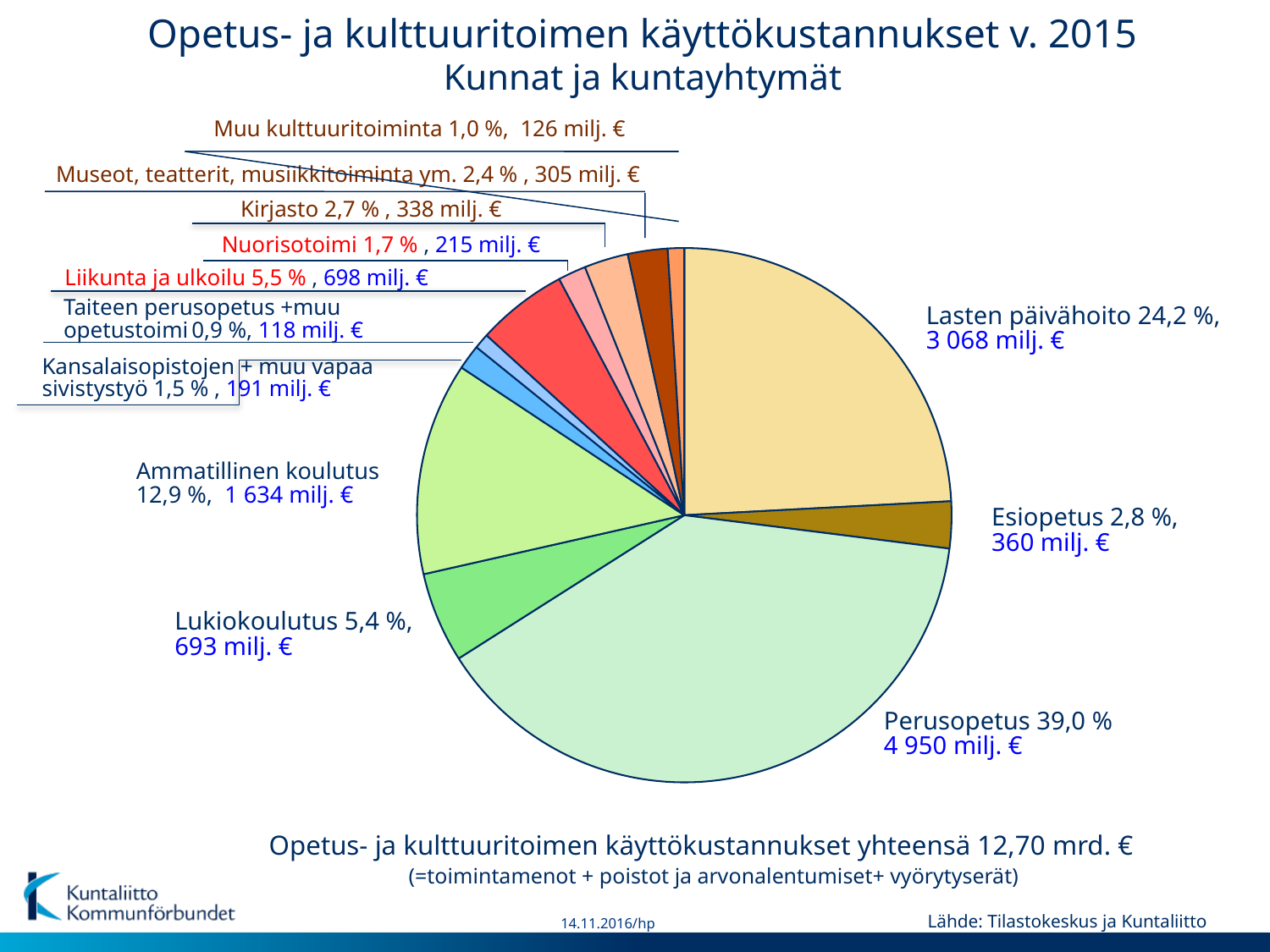
What is the value in milj. € for Perusopetus? 4 950 milj. € What is the total of Opetus- ja kulttuuritoimen käyttökustannukset stated on the slide? 12,70 mrd. € How many slices does the pie chart have? 12 What share of the pie does Esiopetus represent? 2,8 % Which category has the largest slice of the pie? Perusopetus What share of the pie does Liikunta ja ulkoilu represent? 5,5 % What is the value in milj. € for Lasten päivähoito? 3 068 milj. € What kind of chart is shown on the slide? pie chart Which category has the smallest slice of the pie? Taiteen perusopetus + muu opetustoimi What is the difference in milj. € between Perusopetus and Lasten päivähoito? 1 882 milj. € What is the value in milj. € for Ammatillinen koulutus? 1 634 milj. € Which is larger, Kirjasto or Museot, teatterit, musiikkitoiminta ym.? Kirjasto